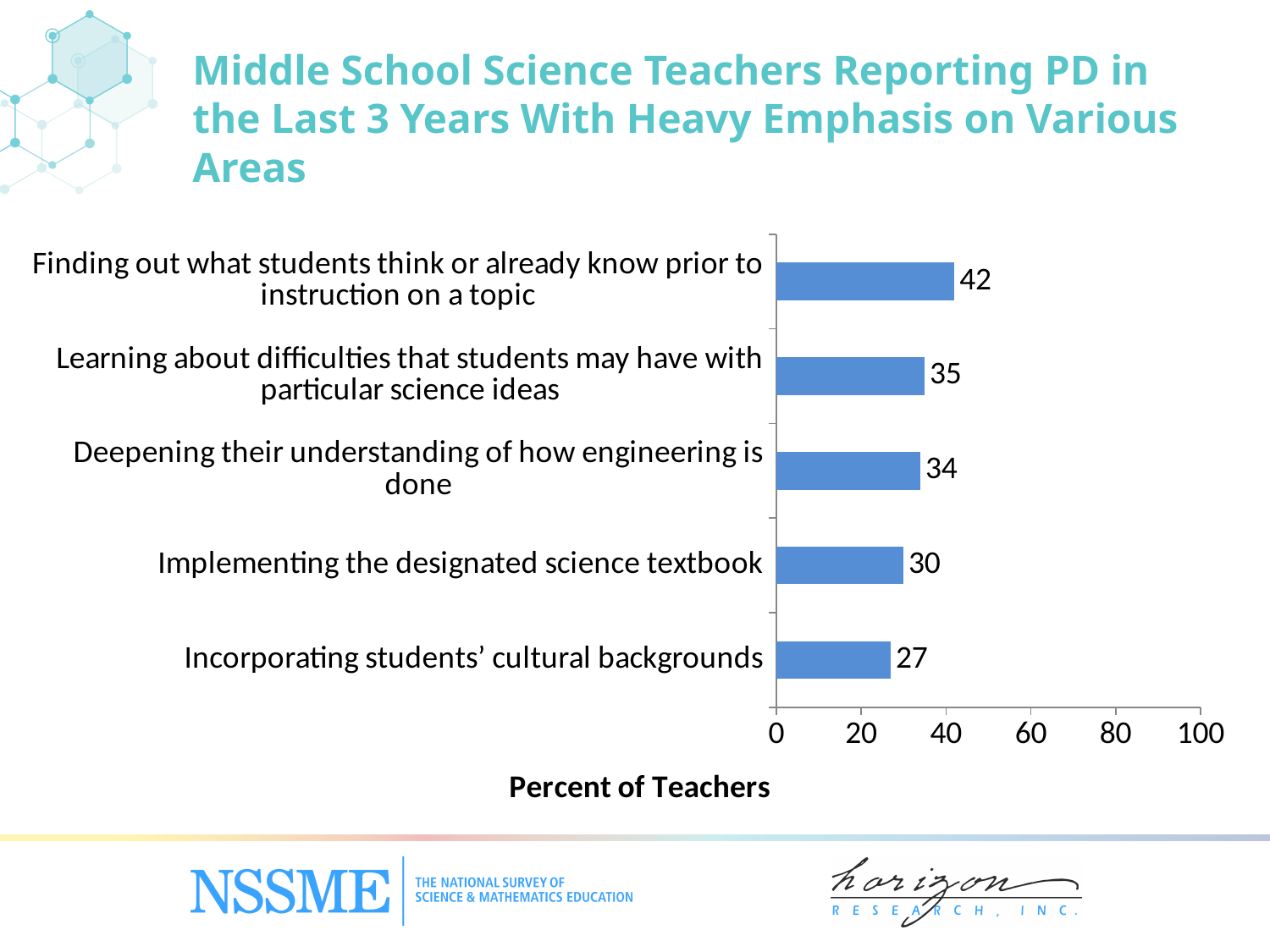
Which is larger: the value for 'Learning about difficulties that students may have with particular science ideas' or 'Implementing the designated science textbook'? Learning about difficulties that students may have with particular science ideas What percent of teachers reported PD with heavy emphasis on finding out what students think or already know prior to instruction on a topic? 42 How many areas are shown in the chart? 5 Which area has the lowest percent of teachers? Incorporating students' cultural backgrounds Which area has the highest percent of teachers? Finding out what students think or already know prior to instruction on a topic Is the value for 'Deepening their understanding of how engineering is done' greater or less than 40? less What kind of chart is shown on the slide? Bar chart What is the difference between the values for 'Finding out what students think or already know prior to instruction on a topic' and 'Incorporating students' cultural backgrounds'? 15 What is the label of the horizontal axis? Percent of Teachers What is the value for 'Incorporating students' cultural backgrounds'? 27 What is the value for 'Implementing the designated science textbook'? 30 What is the difference between the values for 'Learning about difficulties that students may have with particular science ideas' and 'Implementing the designated science textbook'? 5